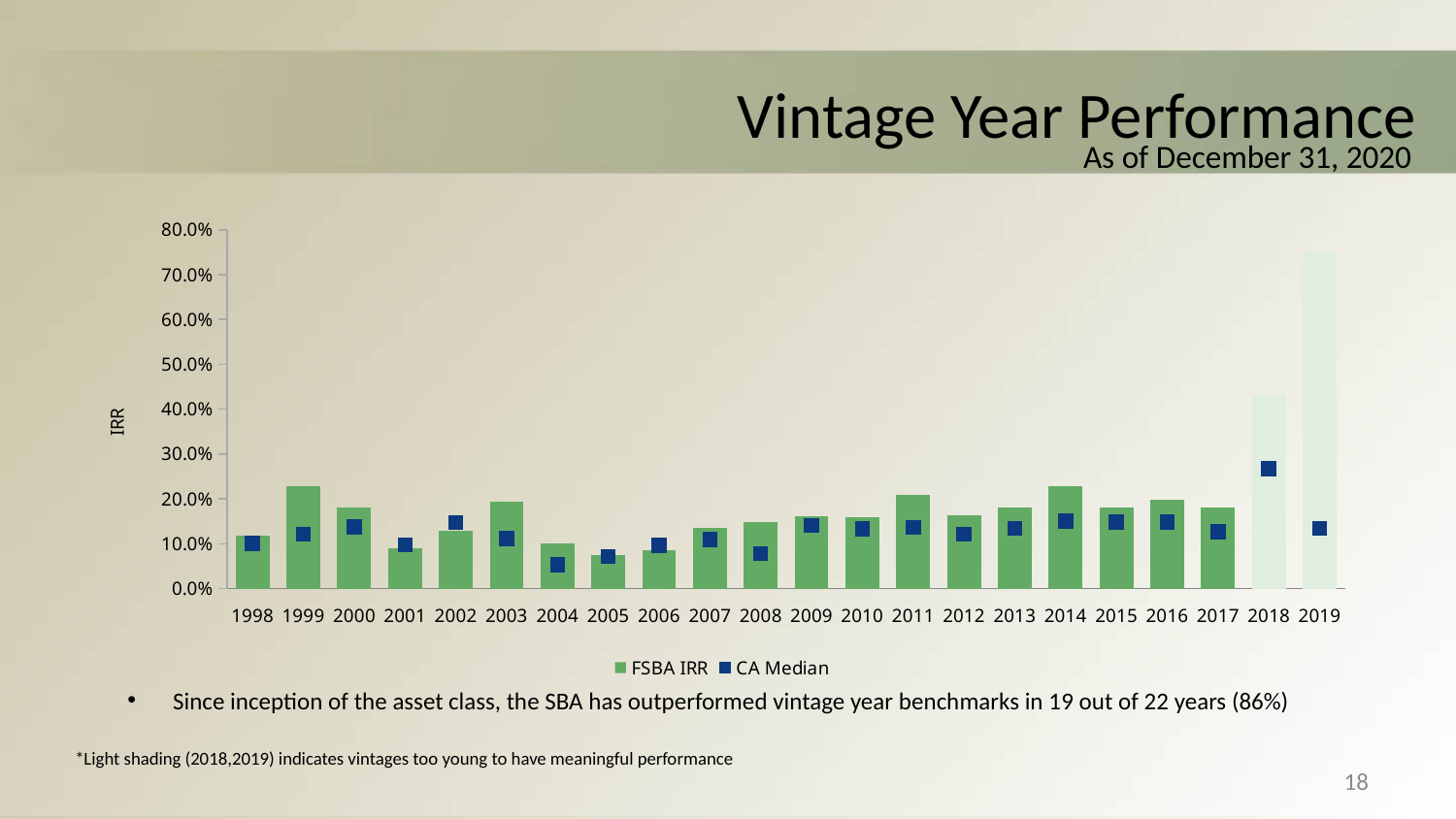
Which vintage year has the highest FSBA IRR bar? 2019 Which vintage year has the larger FSBA IRR, 1998 or 1999? 1999 Which vintage year has the lowest CA Median value? 2004 What kind of chart is shown on the slide? bar chart How many series does the chart's legend list? 2 Is the FSBA IRR for 2018 greater or less than 30.0%? greater Is the FSBA IRR for 2005 greater or less than 10.0%? less Is the FSBA IRR for 2019 greater or less than 70.0%? greater What are the two series named in the chart's legend? FSBA IRR and CA Median Which vintage year has the lowest FSBA IRR bar? 2005 How many vintage years are shown on the x axis of the chart? 22